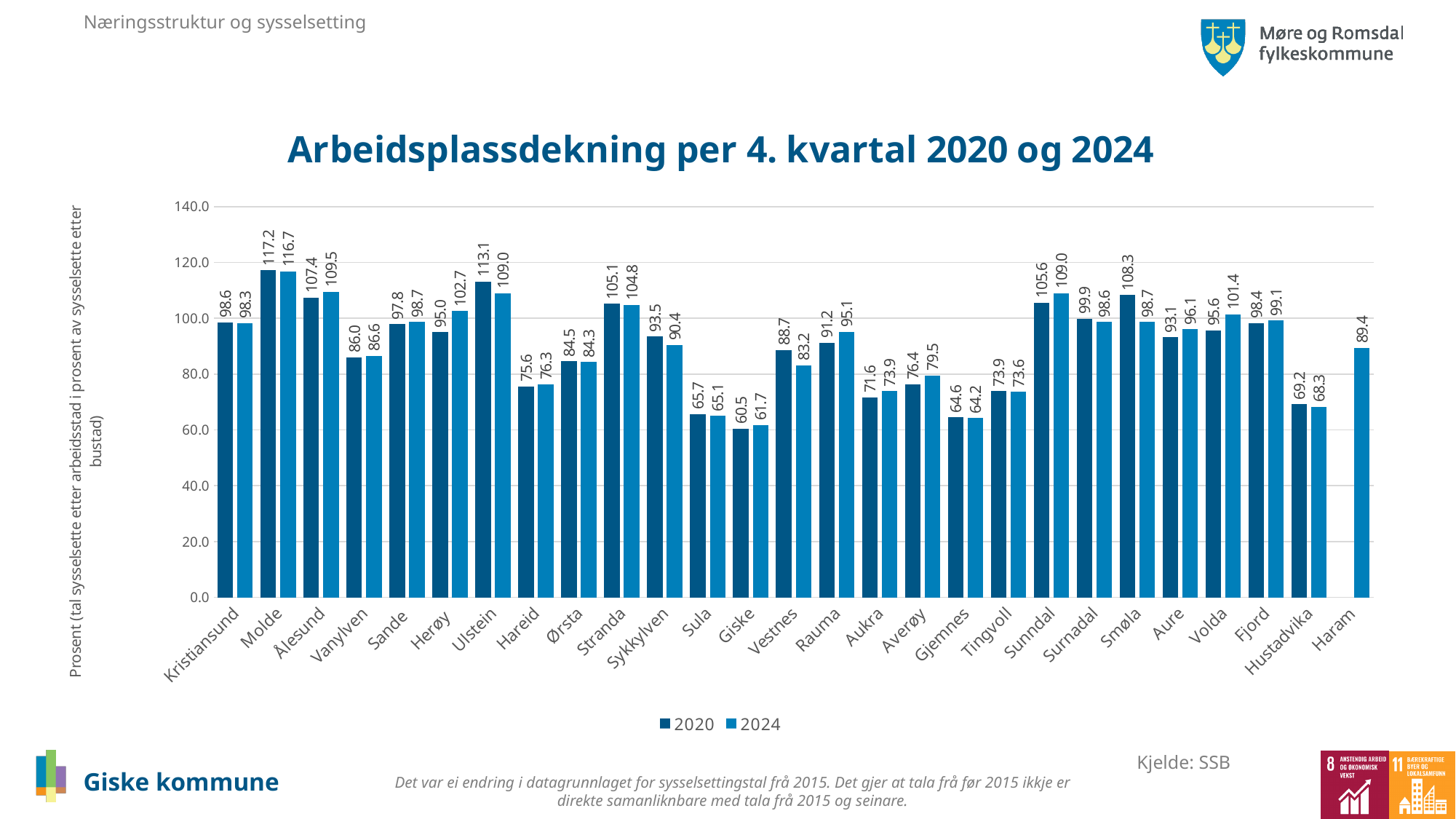
Which is larger for Ulstein, the 2020 value or the 2024 value? 2020 What is the 2024 value for Giske? 61.7 What is the 2024 value for Haram? 89.4 What type of chart is shown on the slide? Bar chart How many series does the legend list? 2 How many municipalities are shown on the x axis? 27 What is the 2020 value for Molde? 117.2 Which municipality has the lowest 2020 value? Giske Is the 2024 value for Sunndal greater or less than 100.0? greater Which municipality has the highest 2024 value? Molde What is the difference between the 2024 and 2020 values for Herøy? 7.7 By how much did Smøla's value fall from 2020 to 2024? 9.6